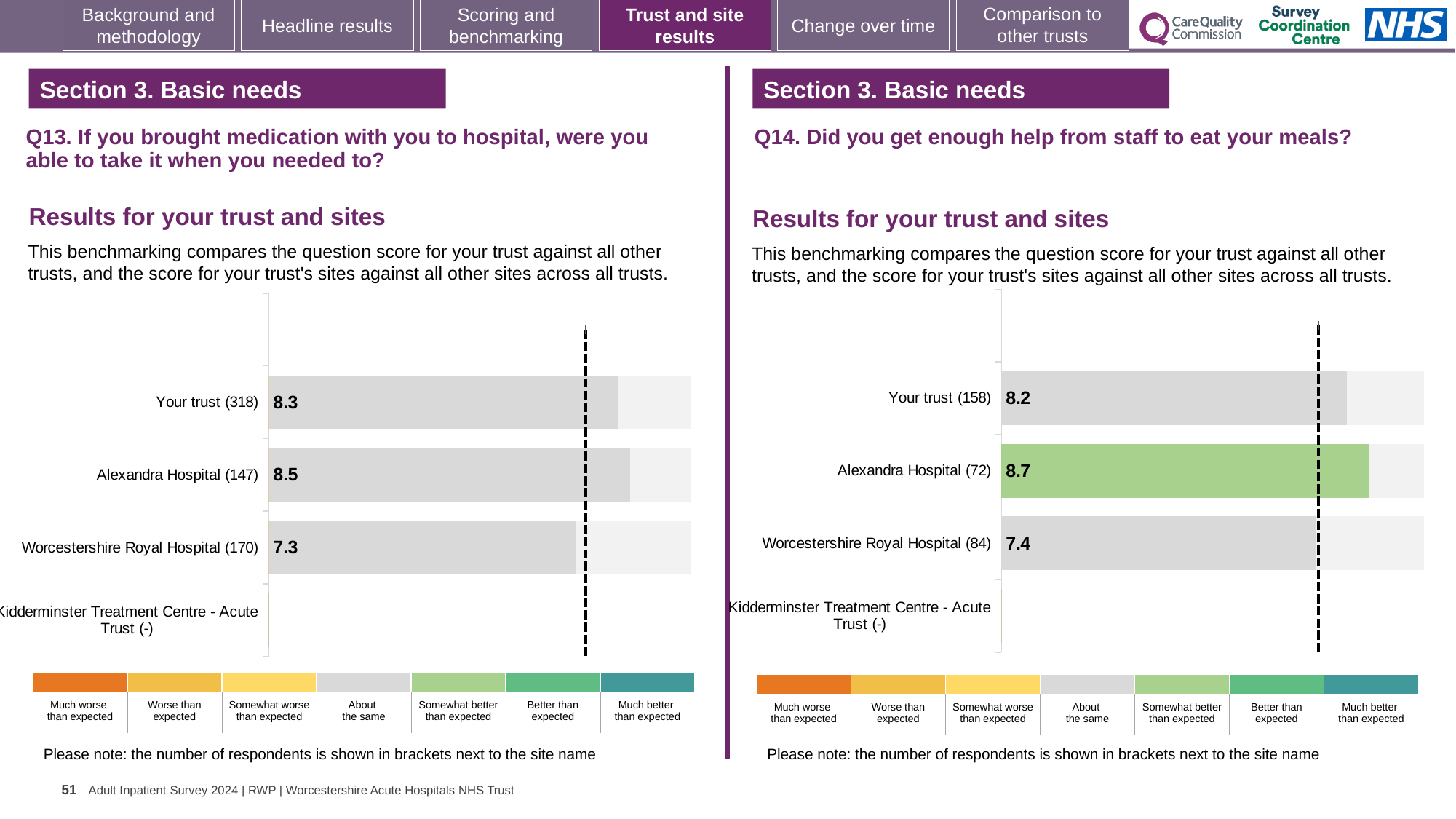
In the Q13 chart, what is the difference between the scores for Alexandra Hospital and Worcestershire Royal Hospital? 1.2 In the Q14 chart, what is the score for Alexandra Hospital? 8.7 In the Q13 chart, how many categories are listed on the vertical axis? 4 In the Q13 chart, which site has the highest score? Alexandra Hospital In the Q14 chart, which has the higher score, Your trust or Worcestershire Royal Hospital? Your trust In the Q14 chart, which site's bar is coloured green? Alexandra Hospital In the Q13 chart, what is the score for Worcestershire Royal Hospital? 7.3 What kind of chart is used for the Q14 results? Bar chart In the Q14 chart, what is the score for Worcestershire Royal Hospital? 7.4 In the Q13 chart, what is the score for Your trust? 8.3 In the Q14 chart, which site has the lowest score? Worcestershire Royal Hospital In the Q14 chart, what is the difference between the scores for Alexandra Hospital and Your trust? 0.5